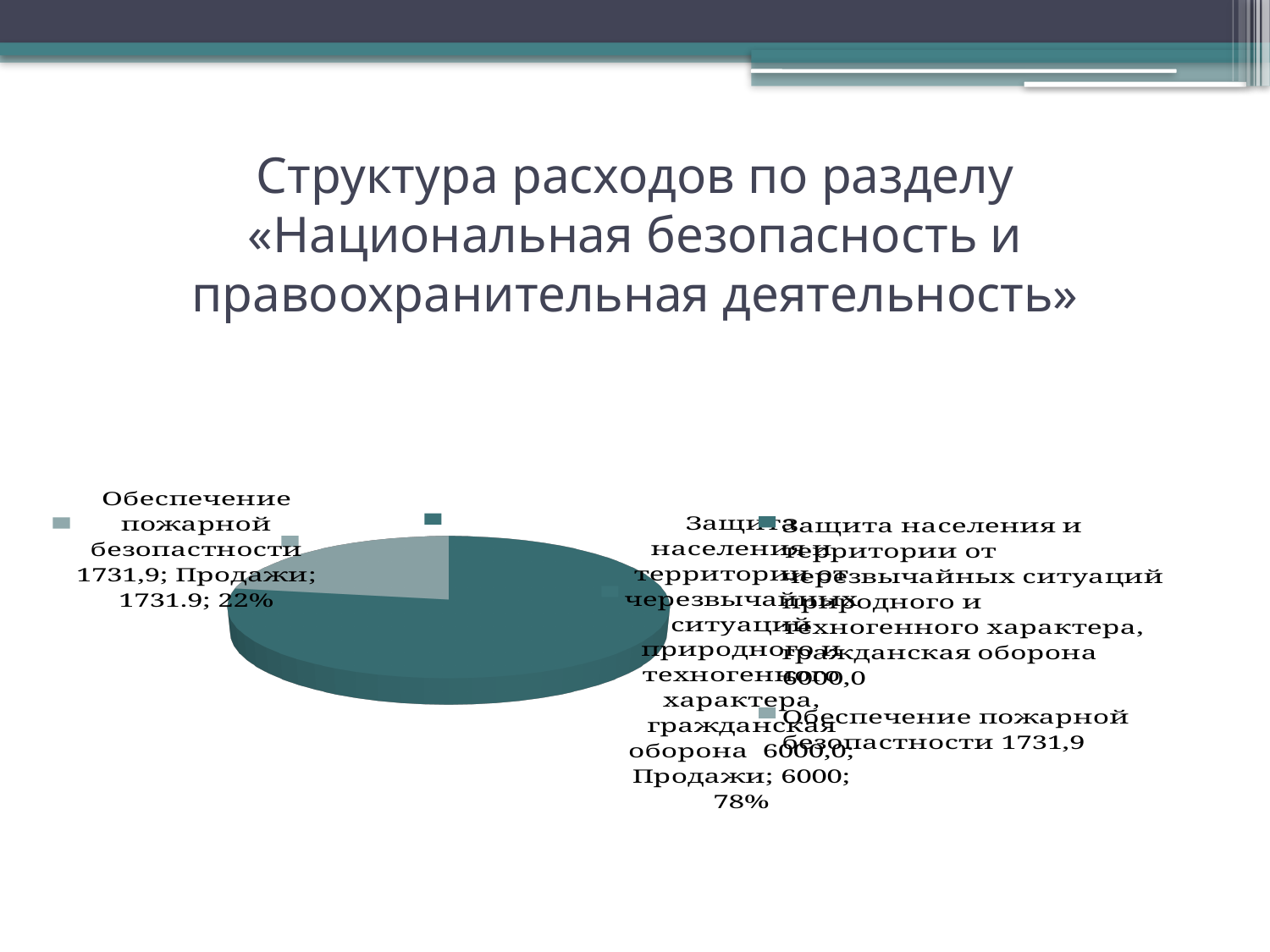
What share of the pie does the slice for "Обеспечение пожарной безопасности" represent? 22% How many slices does the pie chart have? 2 Which slice of the pie chart is the smallest? Обеспечение пожарной безопасности What is the difference in percentage points between the two slices of the pie chart? 56 What value is shown for the slice "Защита населения и территории от чрезвычайных ситуаций природного и техногенного характера, гражданская оборона"? 6000 Which slice of the pie chart is the largest? Защита населения и территории от чрезвычайных ситуаций природного и техногенного характера, гражданская оборона What is the name of the data series shown in the pie chart's data labels? Продажи What value is shown for the slice "Обеспечение пожарной безопасности"? 1731.9 What share of the pie does the slice for "Защита населения и территории от чрезвычайных ситуаций природного и техногенного характера, гражданская оборона" represent? 78% Which is larger: the value for "Обеспечение пожарной безопасности" or the value for "Защита населения и территории от чрезвычайных ситуаций природного и техногенного характера, гражданская оборона"? Защита населения и территории от чрезвычайных ситуаций природного и техногенного характера, гражданская оборона What kind of chart is shown on the slide? pie chart How many entries does the legend of the pie chart list? 2